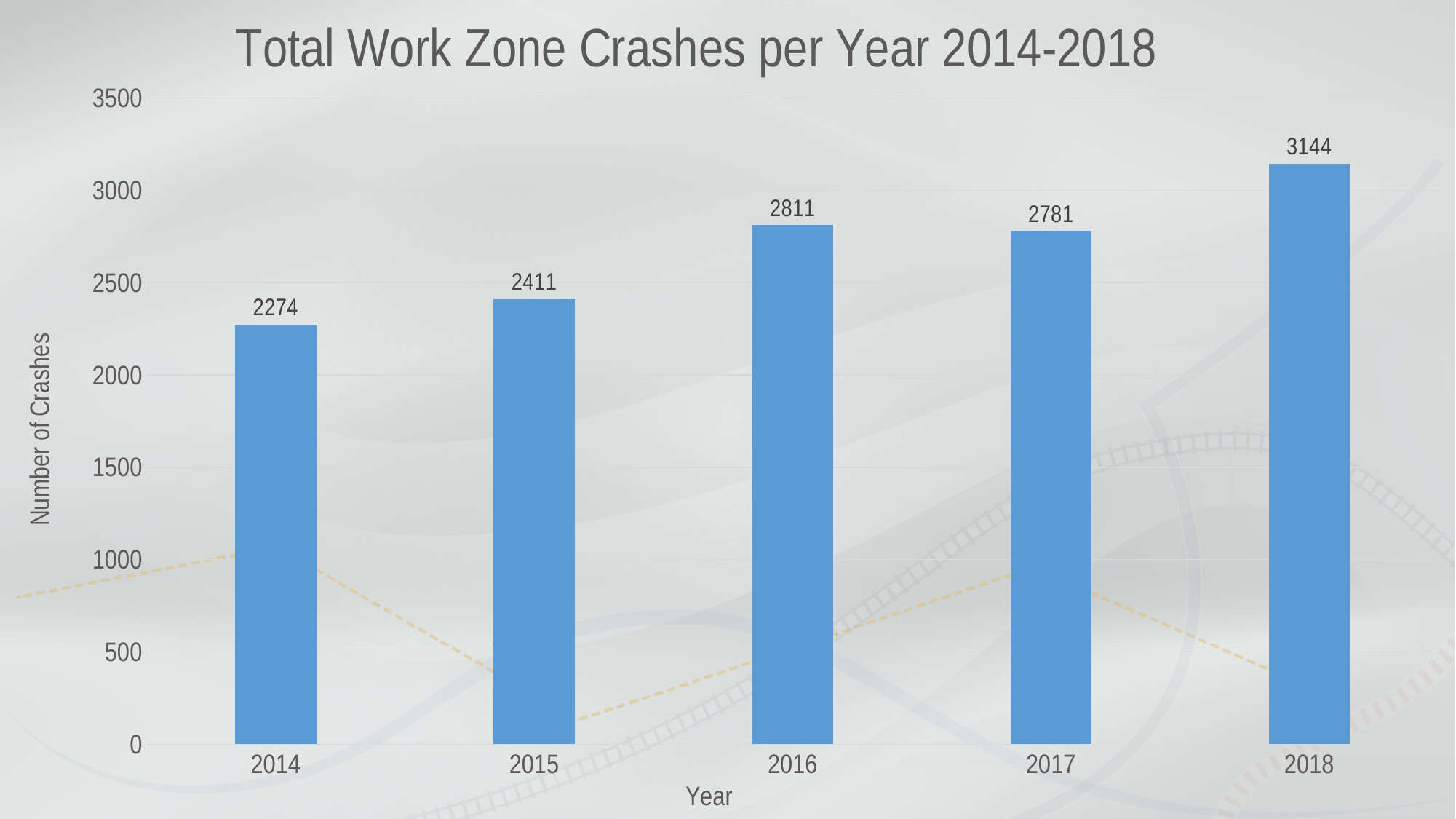
What is the difference in crashes between 2016 and 2017? 30 What is the number of work zone crashes in 2014? 2274 How many years are shown on the chart? 5 What kind of chart is shown on the slide? Bar chart Is the value for 2018 greater or less than 3000? greater Do the crash numbers generally rise or fall from 2014 to 2018? Rise Which year had more crashes, 2015 or 2016? 2016 What is the number of work zone crashes in 2017? 2781 Which year has the lowest number of work zone crashes? 2014 Which year has the highest number of work zone crashes? 2018 What is the title of the chart? Total Work Zone Crashes per Year 2014-2018 What is the difference in crashes between 2018 and 2014? 870